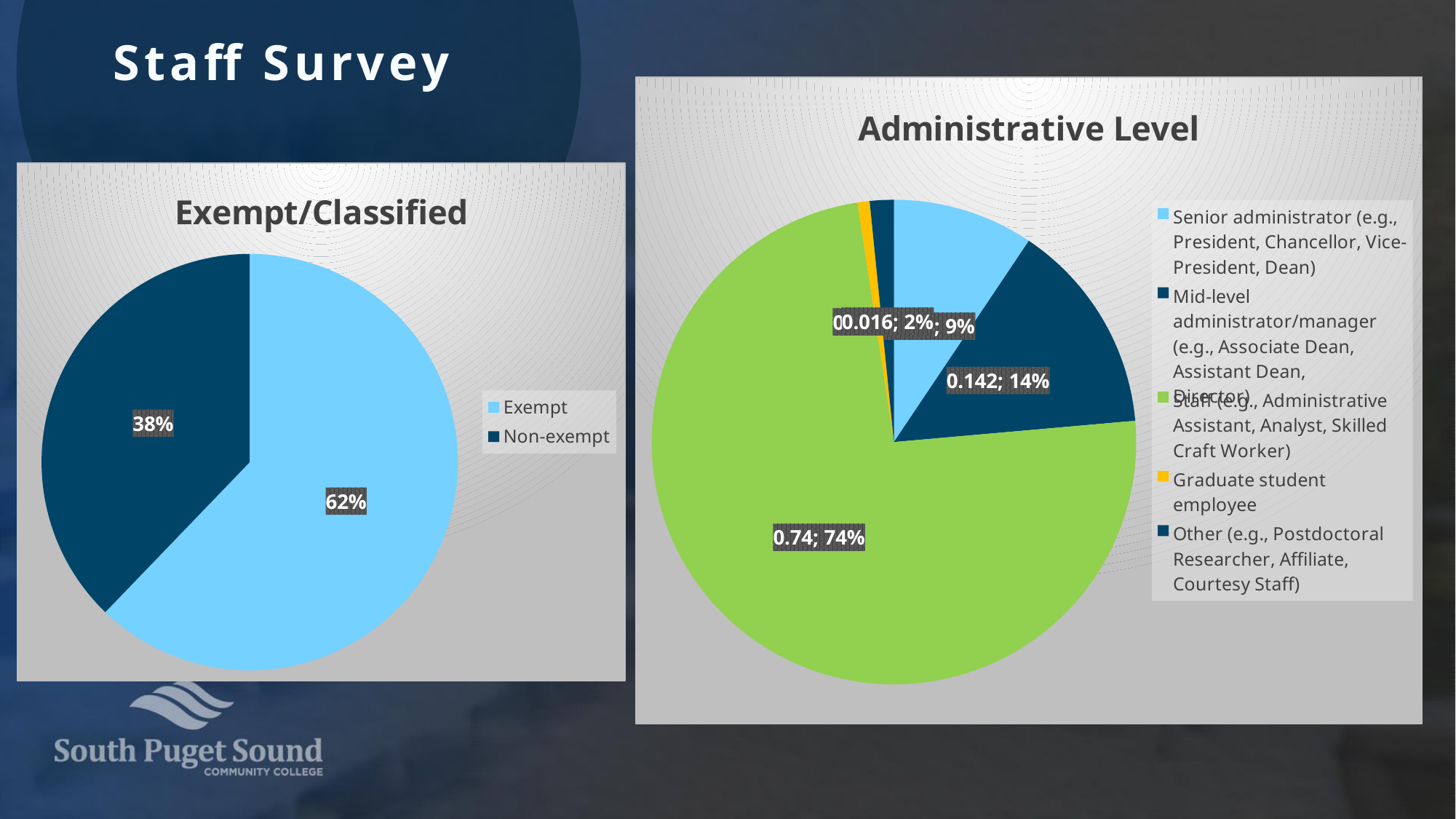
In the Exempt/Classified chart, what percentage is Non-exempt? 38% In the Exempt/Classified chart, what is the difference in percentage points between Exempt and Non-exempt? 24 percentage points In the Exempt/Classified chart, which category has the larger share? Exempt In the Administrative Level chart, what percentage is Staff (e.g., Administrative Assistant, Analyst, Skilled Craft Worker)? 74% How many categories does the Exempt/Classified chart show? 2 In the Administrative Level chart, which category has the largest share? Staff (e.g., Administrative Assistant, Analyst, Skilled Craft Worker) In the Exempt/Classified chart, what percentage is Exempt? 62% How many categories does the legend of the Administrative Level chart list? 5 What type of chart is the Exempt/Classified chart? Pie chart In the Administrative Level chart, what percentage is Senior administrator? 9% In the Administrative Level chart, what percentage is Mid-level administrator/manager? 14% In the Administrative Level chart, what is the difference in percentage points between Staff and Mid-level administrator/manager? 60 percentage points